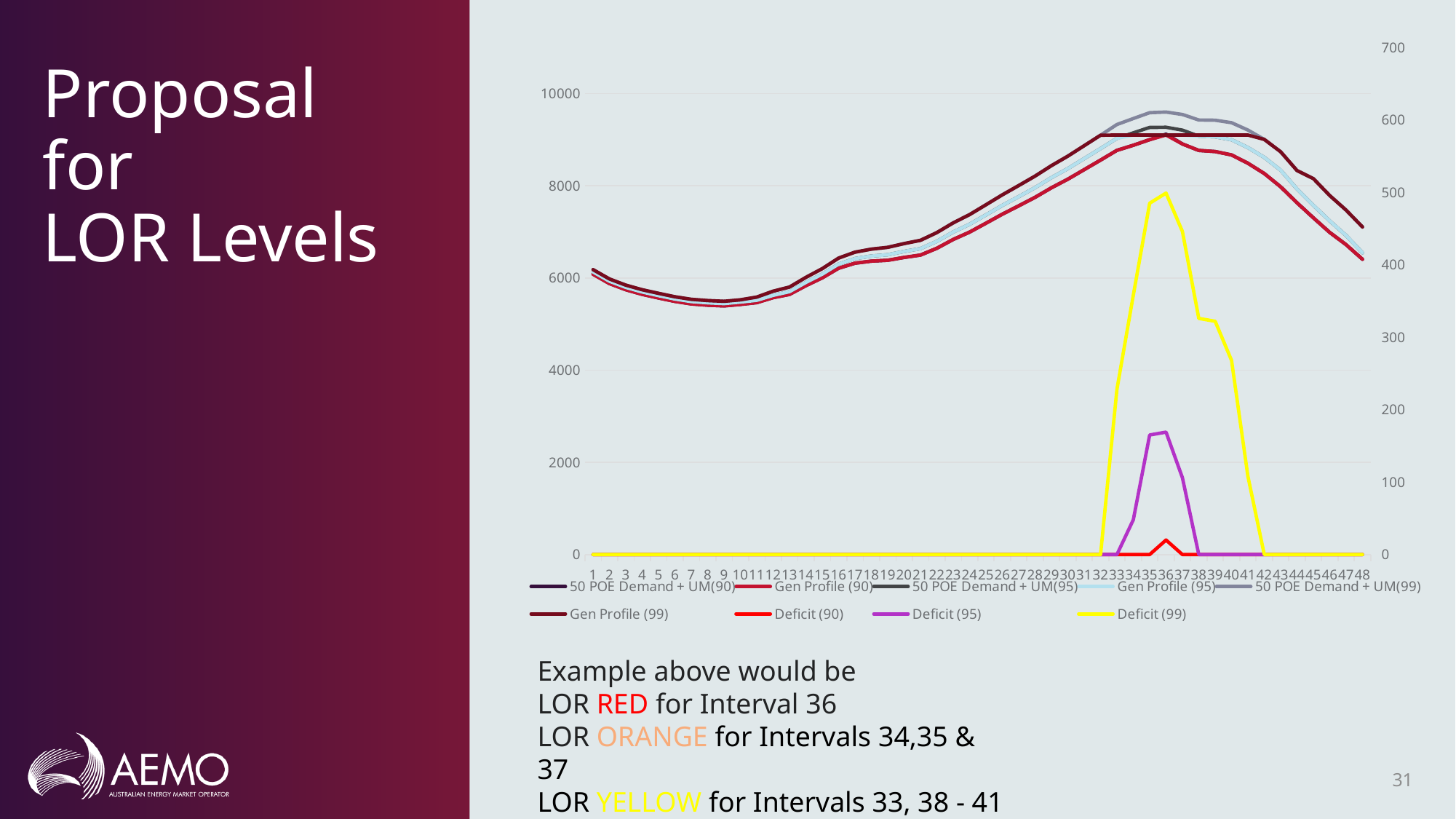
What kind of chart is shown on the slide? line chart On the right-hand axis, is the peak value of Deficit (95) greater or less than 200? less At which interval does the Deficit (99) series reach its peak? 36 Is the value for Gen Profile (90) at interval 9 greater or less than 6000 on the left axis? less How many series does the chart's legend list? 9 Which series is drawn in yellow on the chart? Deficit (99) Which of the three Deficit series has the lowest peak? Deficit (90) Which series is drawn in purple on the chart? Deficit (95) On the right-hand axis, is the peak value of Deficit (99) greater or less than 400? greater Do the demand and generation profile lines rise or fall between interval 9 and interval 36? rise How many intervals are plotted along the x axis of the chart? 48 Which of the three Deficit series reaches the highest peak? Deficit (99)